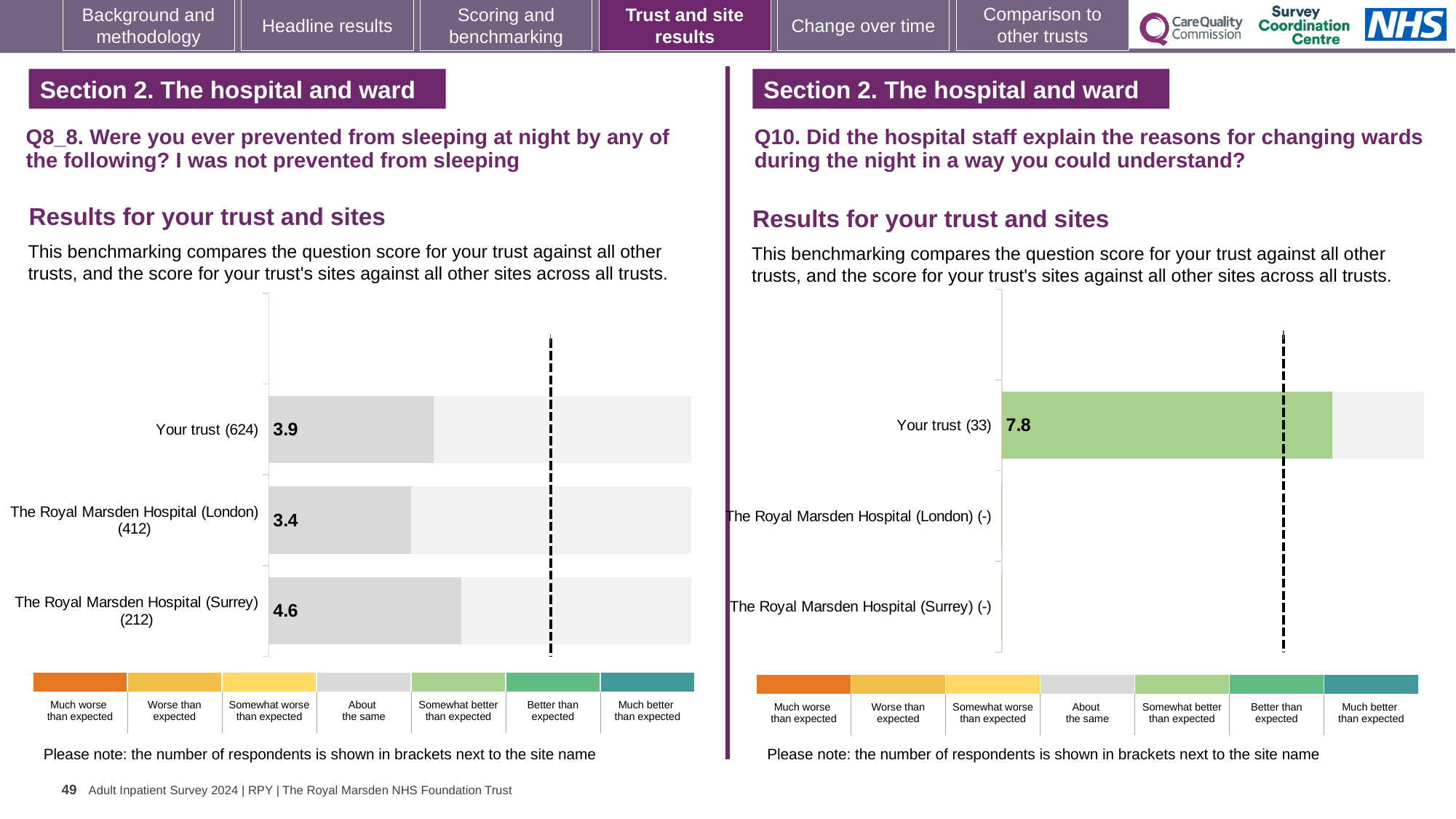
In the Q8_8 chart on the left, how many bars are plotted? 3 In the Q8_8 chart on the left, what is the score for The Royal Marsden Hospital (Surrey) (212)? 4.6 In the Q10 chart on the right, what is the score for Your trust (33)? 7.8 In the Q8_8 chart on the left, what is the difference between the Surrey score and the London score? 1.2 What kind of chart is used on the left for Q8_8? Bar chart In the Q10 chart on the right, how many sites or trusts have a score bar plotted? 1 In the Q8_8 chart on the left, what is the score for The Royal Marsden Hospital (London) (412)? 3.4 In the Q8_8 chart on the left, which is larger: the score for Your trust or the score for The Royal Marsden Hospital (London)? Your trust In the Q8_8 chart on the left, which site or trust has the lowest score? The Royal Marsden Hospital (London) (412) In the Q8_8 chart on the left, which site or trust has the highest score? The Royal Marsden Hospital (Surrey) (212) In the Q10 chart on the right, which benchmark category does the colour of the Your trust bar correspond to in the legend? Somewhat better than expected In the Q8_8 chart on the left, what is the score for Your trust (624)? 3.9